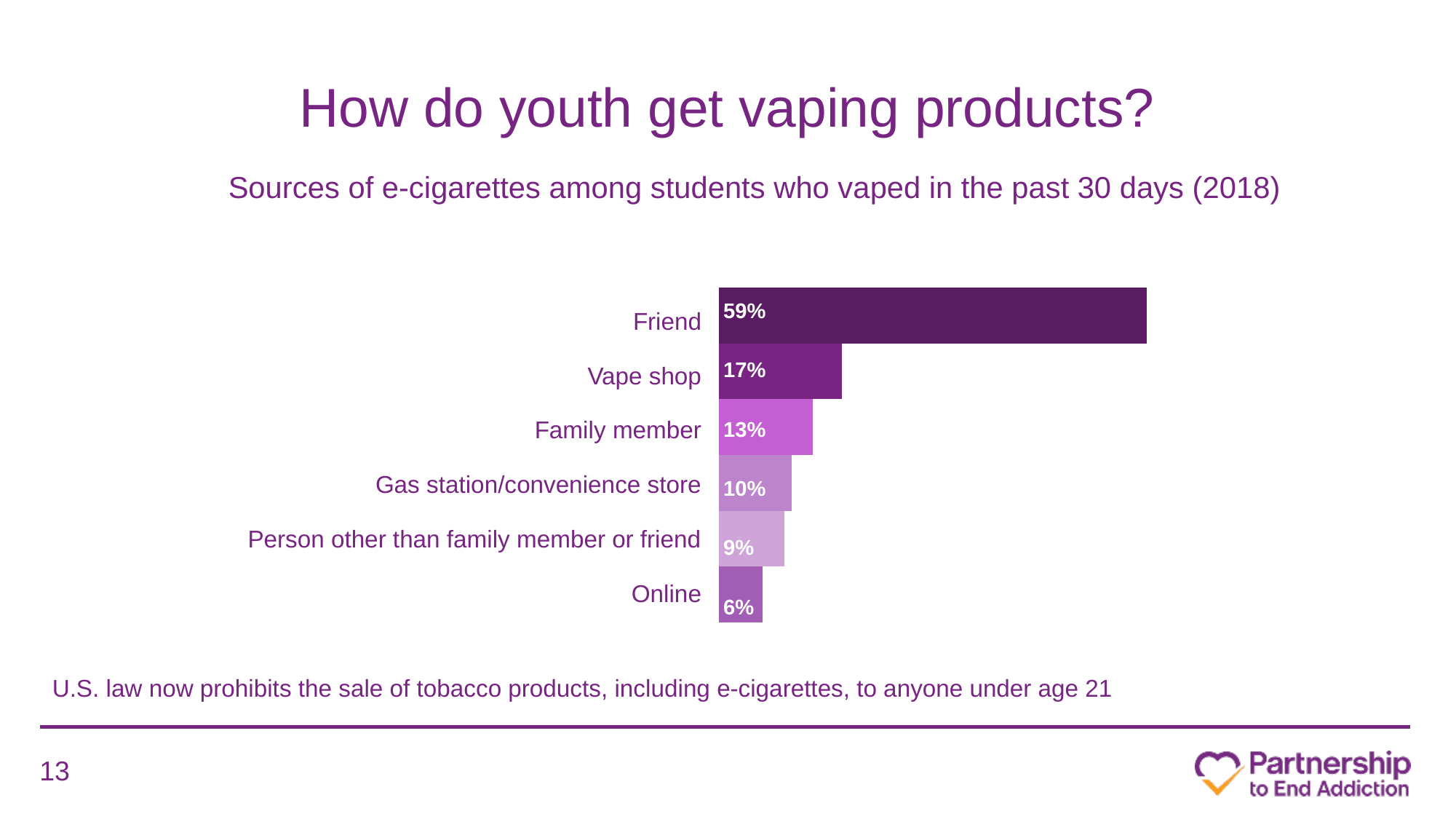
What is the value shown for Gas station/convenience store? 10% What percentage of students who vaped in the past 30 days got e-cigarettes from a friend? 59% What is the value shown for Vape shop? 17% How many sources (categories) are shown in the chart? 6 What kind of chart is shown on the slide? Bar chart Which is larger, the value for Family member or the value for Person other than family member or friend? Family member What is the subtitle describing the chart's data? Sources of e-cigarettes among students who vaped in the past 30 days (2018) What is the difference between the Friend and Vape shop percentages? 42% Which source has the lowest percentage? Online What is the value shown for Online? 6% Which source has the highest percentage? Friend What is the value shown for Family member? 13%